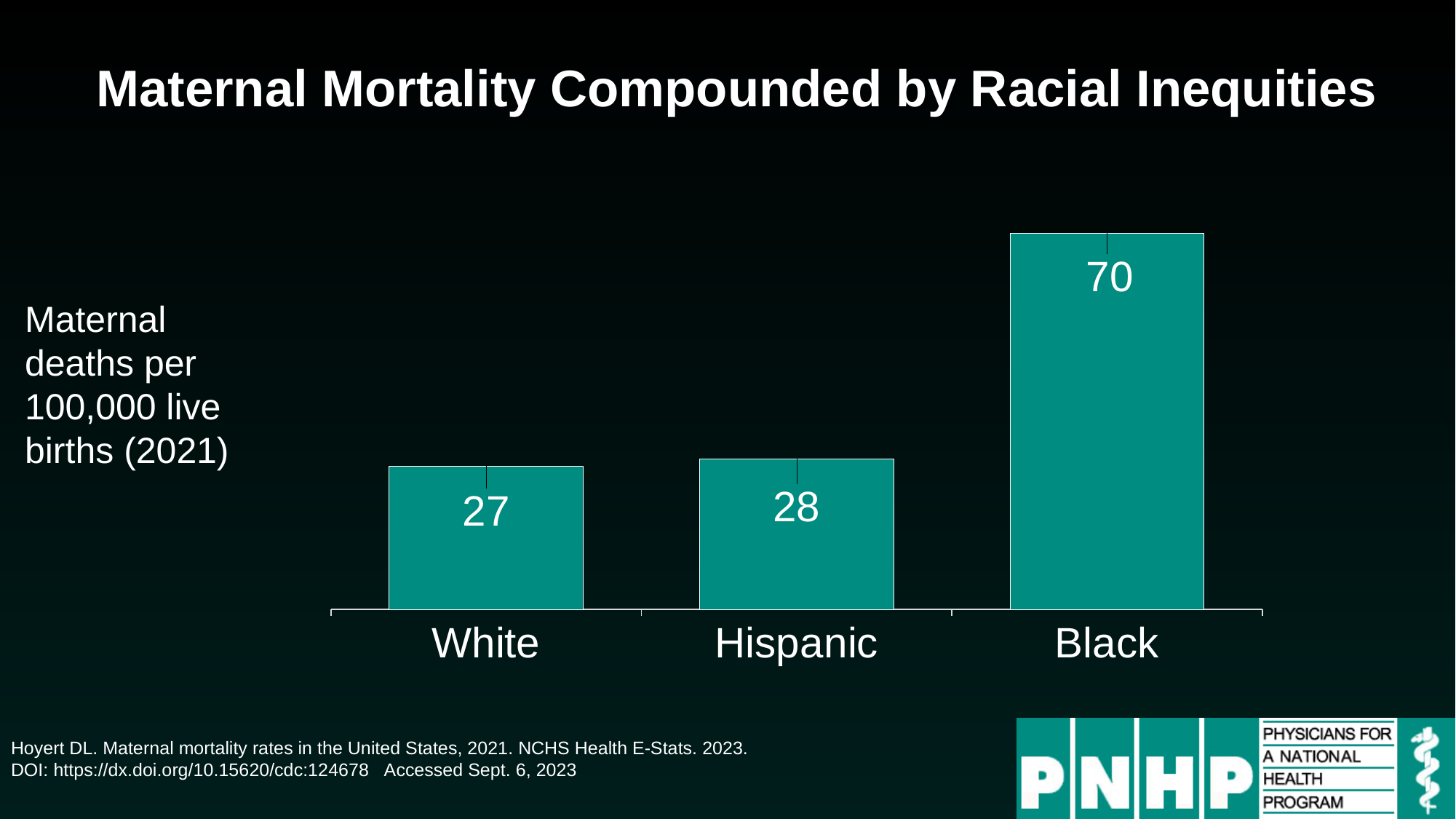
Which category has the highest maternal mortality rate? Black What is the value for Hispanic on the chart? 28 Which category has the lowest maternal mortality rate? White Which is larger, the value for Black or the value for Hispanic? Black What kind of chart is shown on the slide? Bar chart How many categories are shown on the chart? 3 Do the values rise or fall moving from left to right across the categories? Rise What is the value for White on the chart? 27 What is the difference between the values for Black and White? 43 What is the difference between the values for Hispanic and White? 1 What is the maternal mortality rate for Black women shown on the chart? 70 What is the title of the slide? Maternal Mortality Compounded by Racial Inequities